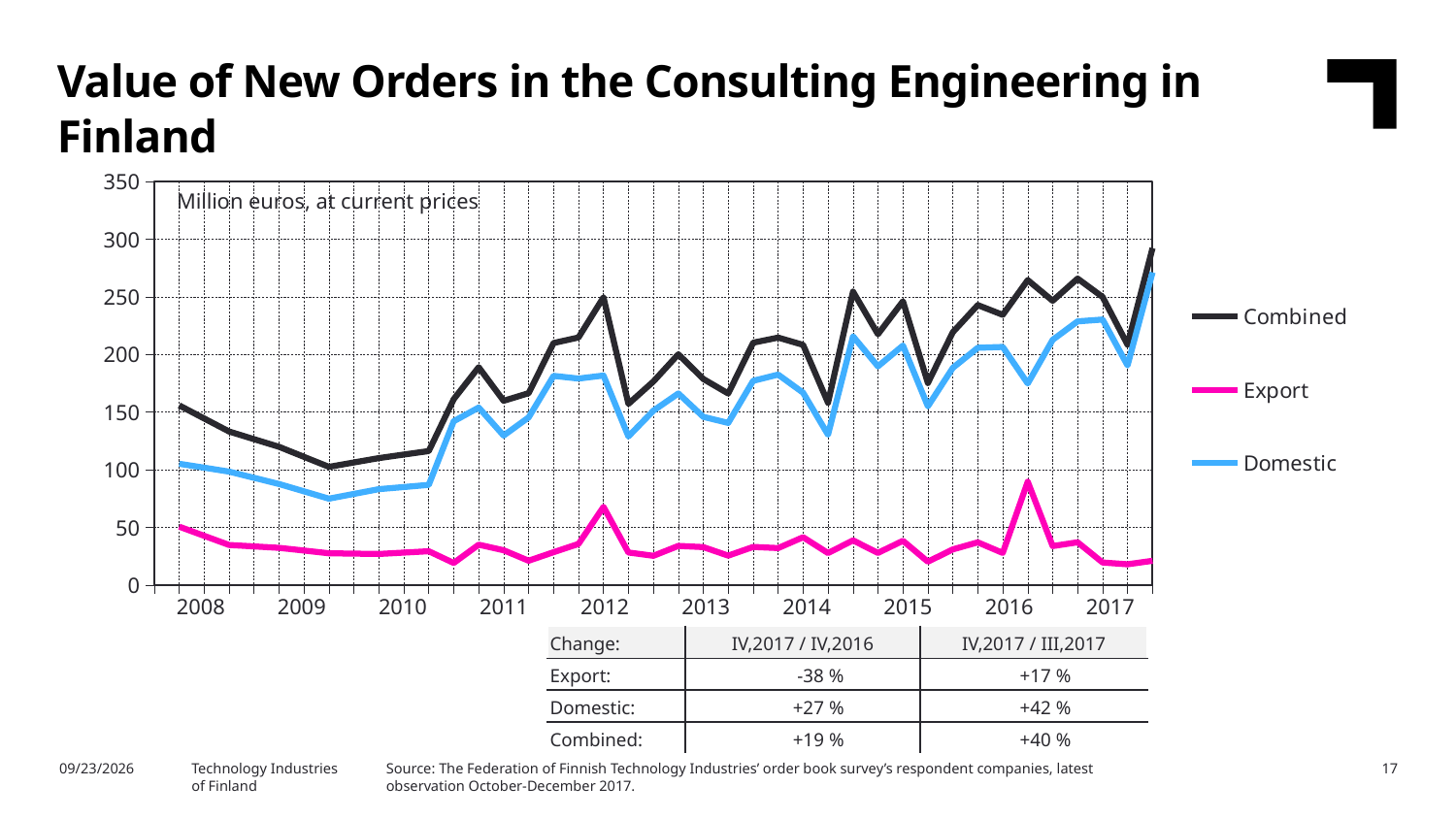
Which series has the lowest values throughout the chart? Export What unit is stated inside the chart area? Million euros, at current prices Is the peak value for Export in 2016 greater or less than 50? greater Is the Export peak in 2012 greater or less than 100? less What colour is the Export line? pink Is the value for Combined at the last point in 2017 greater or less than 250? greater Do the Combined values rise or fall from 2008 to 2009? fall What kind of chart is shown on the slide? line chart Which is larger at the end of 2017, Domestic or Export? Domestic How many series does the legend list? 3 Which series has the highest values throughout the chart? Combined